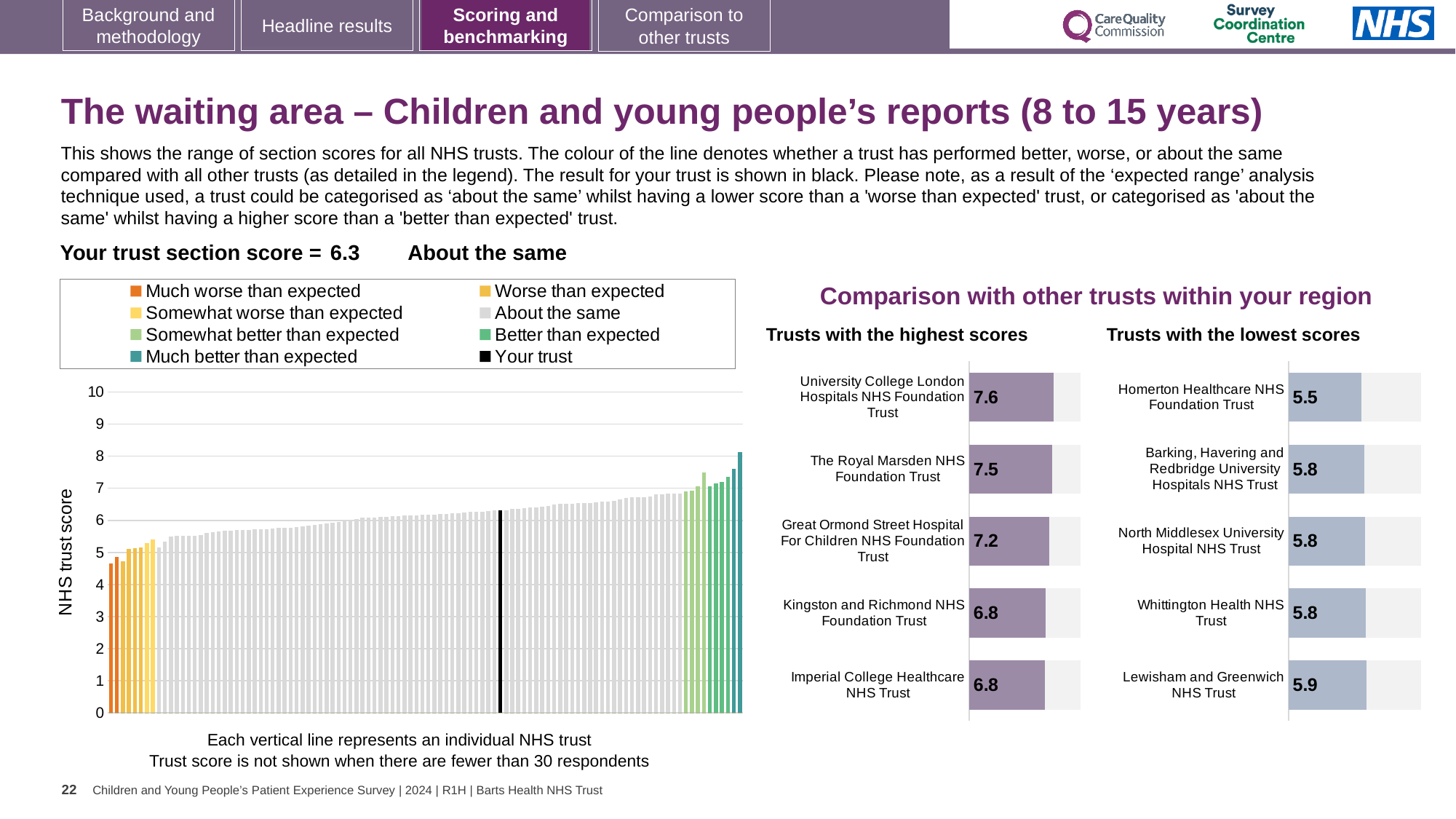
In the 'Trusts with the highest scores' chart, which trust has the highest score? University College London Hospitals NHS Foundation Trust In the 'Trusts with the lowest scores' chart, what is the score for Homerton Healthcare NHS Foundation Trust? 5.5 In the 'Trusts with the lowest scores' chart, what is the score for Lewisham and Greenwich NHS Trust? 5.9 How many trusts are listed in the 'Trusts with the lowest scores' chart? 5 In the 'Trusts with the highest scores' chart, what is the score for Great Ormond Street Hospital For Children NHS Foundation Trust? 7.2 In the main 'NHS trust score' chart on the left, do the bar values rise or fall from left to right? rise In the 'Trusts with the highest scores' chart, which has the larger score: The Royal Marsden NHS Foundation Trust or Great Ormond Street Hospital For Children NHS Foundation Trust? The Royal Marsden NHS Foundation Trust In the 'Trusts with the highest scores' chart, what is the score for University College London Hospitals NHS Foundation Trust? 7.6 What kind of chart is the main 'NHS trust score' chart on the left? bar chart In the 'Trusts with the highest scores' chart, what is the difference between the scores of University College London Hospitals NHS Foundation Trust and Imperial College Healthcare NHS Trust? 0.8 In the main 'NHS trust score' chart on the left, what is the section score for your trust (the black bar)? 6.3 In the 'Trusts with the lowest scores' chart, which trust has the lowest score? Homerton Healthcare NHS Foundation Trust